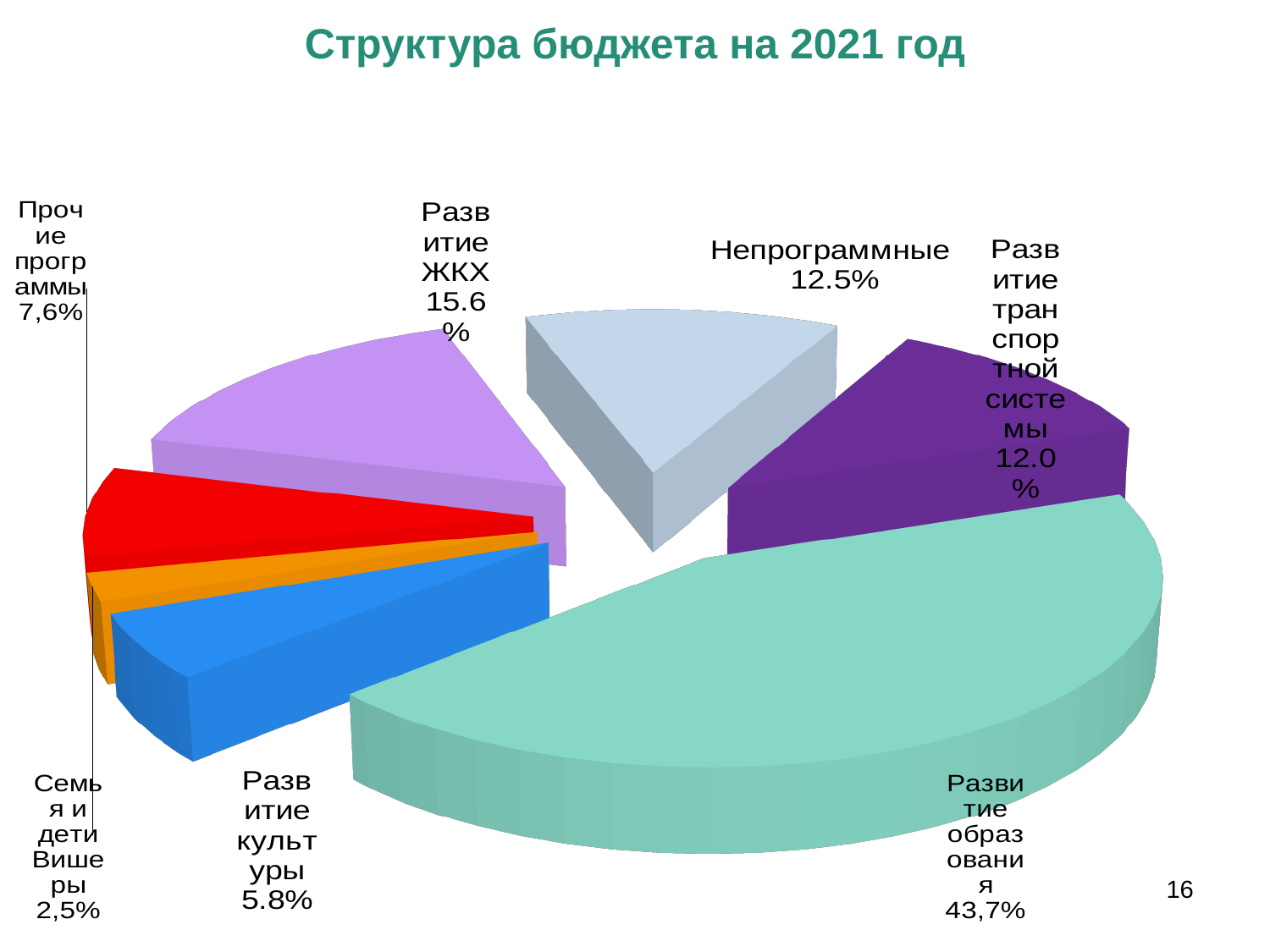
What is the difference between the shares for Развитие ЖКХ and Непрограммные? 3.1% What is the title of the chart? Структура бюджета на 2021 год Which category has the largest share of the budget? Развитие образования What kind of chart is shown on the slide? Pie chart Which is larger: the share for Развитие ЖКХ or the share for Непрограммные? Развитие ЖКХ What share of the budget goes to Развитие ЖКХ? 15.6% What is the value shown for Непрограммные? 12.5% What is the value shown for Семья и дети Вишеры? 2,5% How many slices does the pie chart have? 7 What share of the budget goes to Развитие образования? 43,7% Which category has the smallest share of the budget? Семья и дети Вишеры What share is shown for Развитие транспортной системы? 12.0%